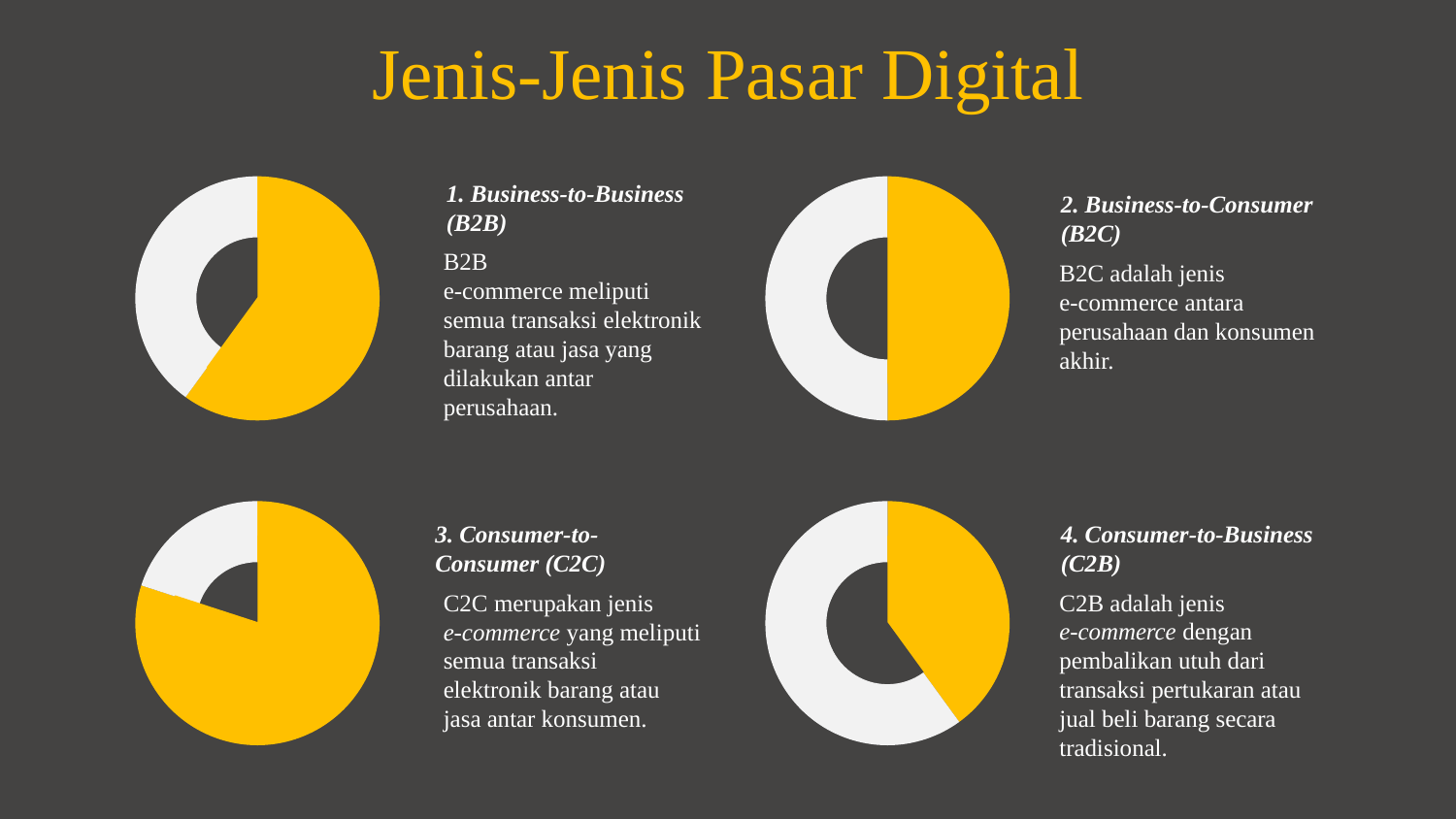
In the chart next to '4. Consumer-to-Business (C2B)', which slice is smaller, the yellow one or the white one? yellow In the chart next to '1. Business-to-Business (B2B)', which slice is larger, the yellow one or the white one? yellow How many doughnut charts are on the slide? 4 In the chart next to '1. Business-to-Business (B2B)', how many slices does the doughnut have? 2 What is the title of the slide containing the four doughnut charts? Jenis-Jenis Pasar Digital What kind of chart is shown next to the heading '1. Business-to-Business (B2B)'? doughnut chart In the chart next to '4. Consumer-to-Business (C2B)', which slice is larger, the yellow one or the white one? white Which two colours are used for the slices in the doughnut charts on the slide? yellow and white In the chart next to '3. Consumer-to-Consumer (C2C)', how many slices does the doughnut have? 2 In the chart next to '3. Consumer-to-Consumer (C2C)', which slice is larger, the yellow one or the white one? yellow What kind of chart is shown next to the heading '4. Consumer-to-Business (C2B)'? doughnut chart